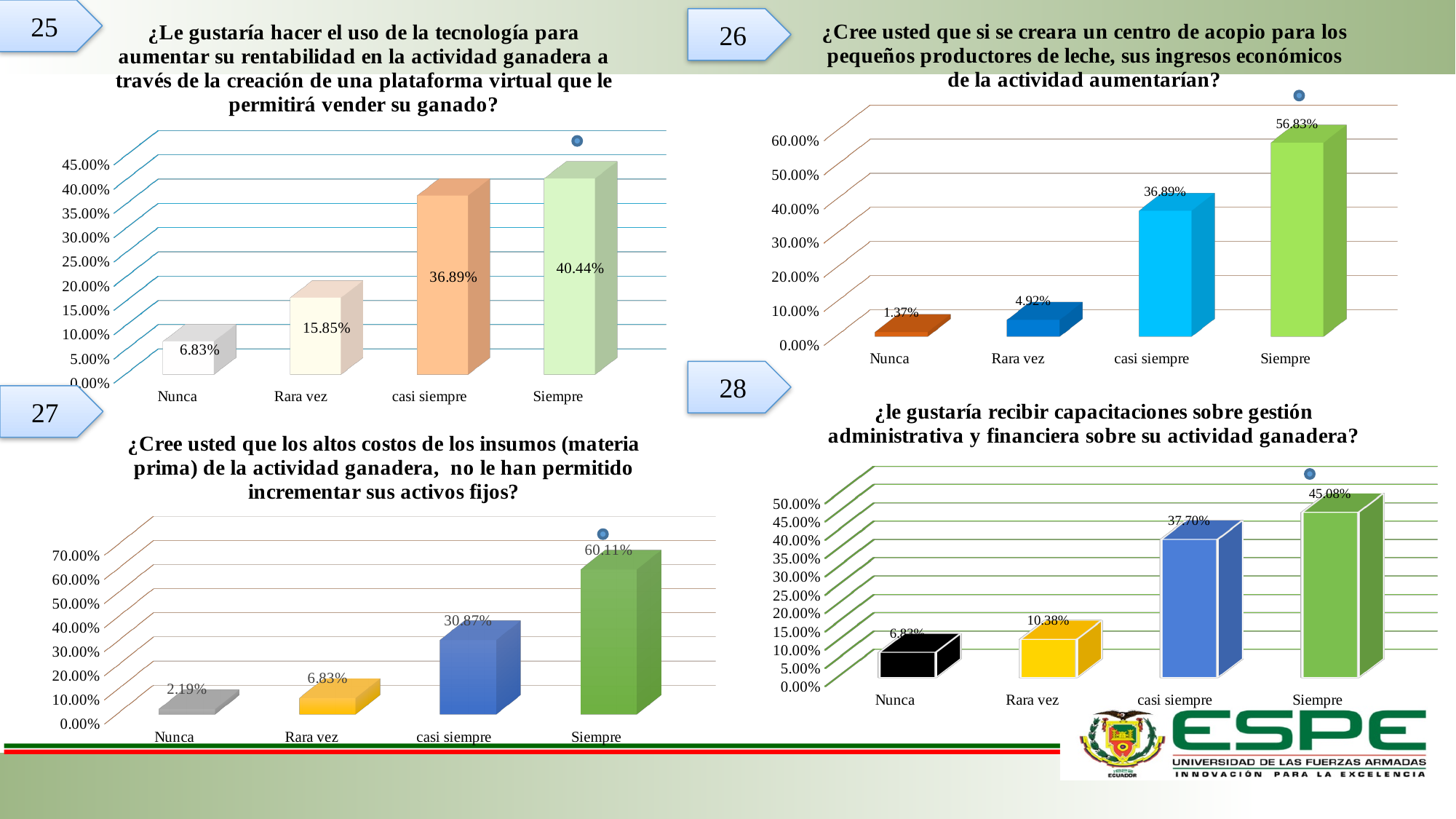
In chart 28 (bottom-right), what is the value for casi siempre? 37.70% In chart 26 (top-right), which category has the highest value? Siempre In chart 25 (top-left), what is the value for Rara vez? 15.85% In chart 26 (top-right), what is the difference between Siempre and casi siempre? 19.94% What kind of chart is chart 27 (bottom-left)? Bar chart In chart 27 (bottom-left), what is the value for Siempre? 60.11% In chart 27 (bottom-left), which category has the lowest value? Nunca How many categories are shown in chart 28 (bottom-right)? 4 In chart 25 (top-left), what is the value for Siempre? 40.44% In chart 26 (top-right), what is the value for Nunca? 1.37% In chart 28 (bottom-right), which is larger, Rara vez or Nunca? Rara vez In chart 25 (top-left), do the values rise or fall from Nunca to Siempre? Rise